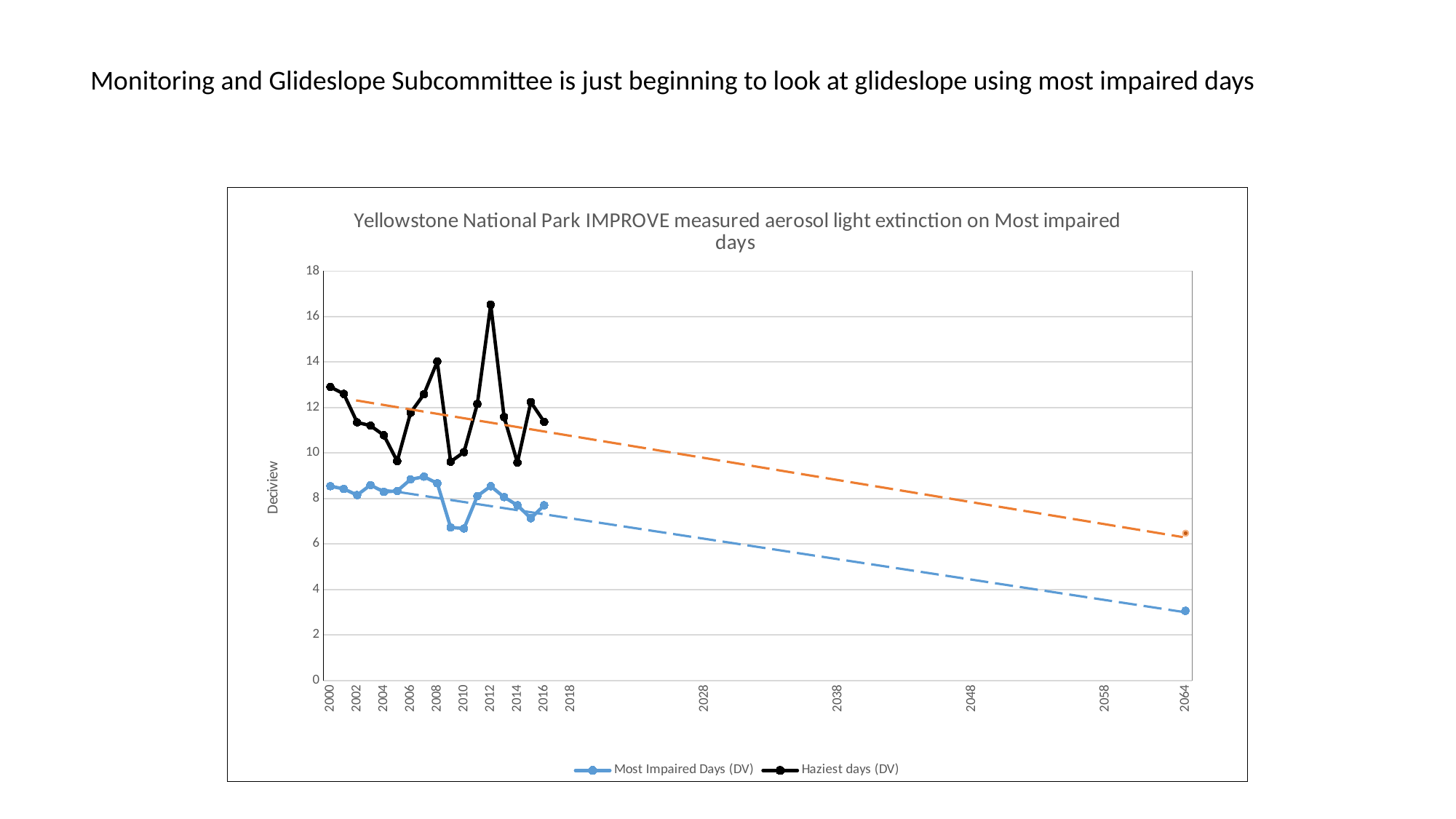
How many series does the legend list? 2 Is the projected Most Impaired Days (DV) value for 2064 greater or less than 4? less What is the label on the vertical axis of the chart? Deciview Is the Haziest days (DV) value for 2008 greater or less than 12? greater What are the two series named in the legend? Most Impaired Days (DV) and Haziest days (DV) Do the dashed projection lines rise or fall from 2016 toward 2064? fall In which year does the Haziest days (DV) series reach its highest value? 2012 Is the Most Impaired Days (DV) value for 2000 greater or less than 8? greater What kind of chart is shown on the slide? line chart In 2012, which series has the higher value: Most Impaired Days (DV) or Haziest days (DV)? Haziest days (DV)